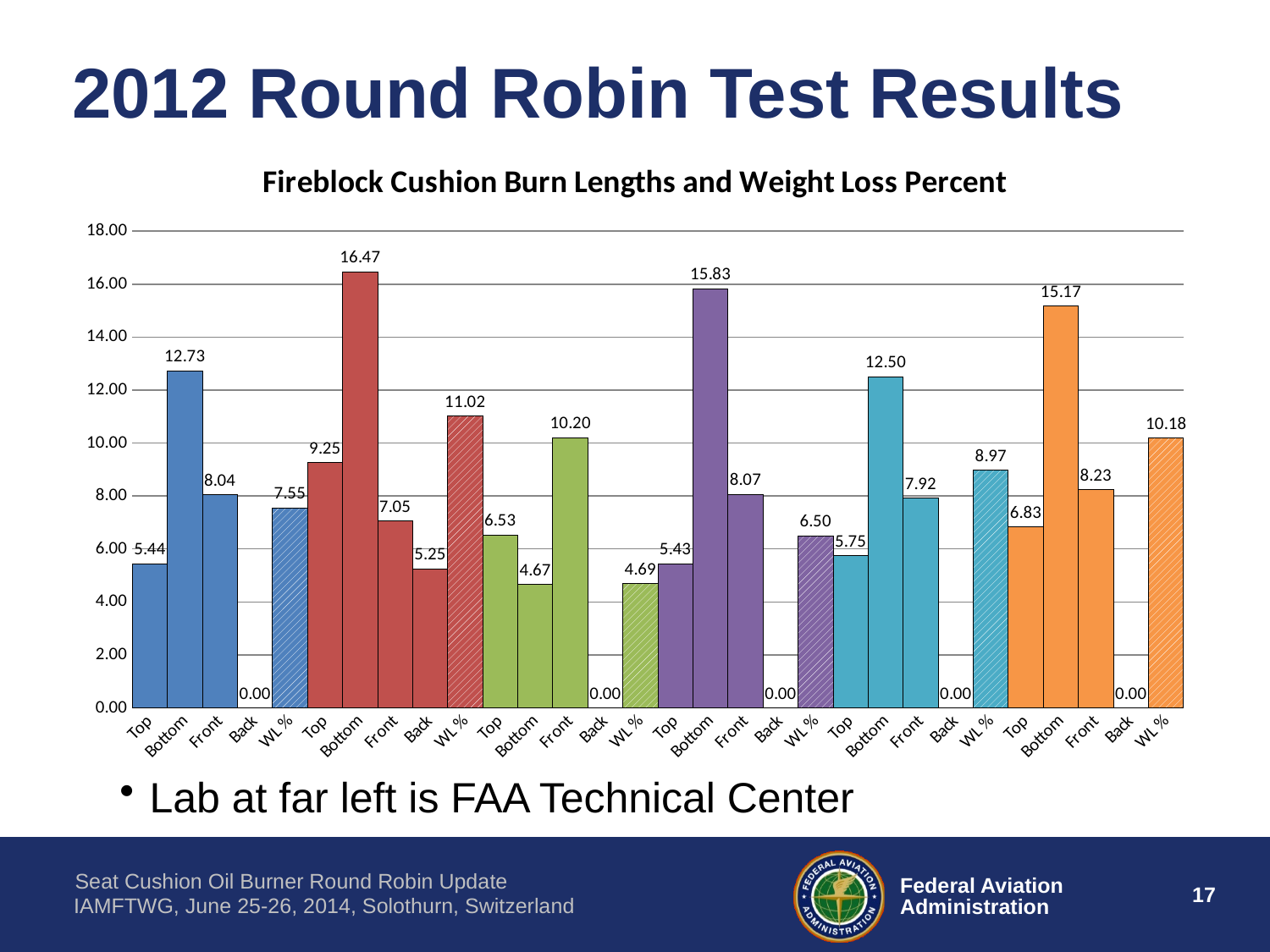
Which is larger: the Bottom bar in the purple group or the Bottom bar in the teal group? Bottom in the purple group (15.83) What is the value of the Bottom bar in the far-left blue group? 12.73 Is the WL % value in the far-right orange group greater or less than 10.00? greater What is the value of the Bottom bar in the far-right orange group? 15.17 How many bars are plotted on the chart in total? 30 What is the title of the chart? Fireblock Cushion Burn Lengths and Weight Loss Percent Which bar has the highest value on the chart? Bottom in the red group (16.47) What is the value of the Front bar in the green group (third group from the left)? 10.20 How many groups of bars (labs) are shown on the chart? 6 What is the value of the WL % bar in the red group (second group from the left)? 11.02 What kind of chart is shown on the slide? bar chart What is the difference between the Bottom bar (16.47) and the Top bar (9.25) in the red group? 7.22